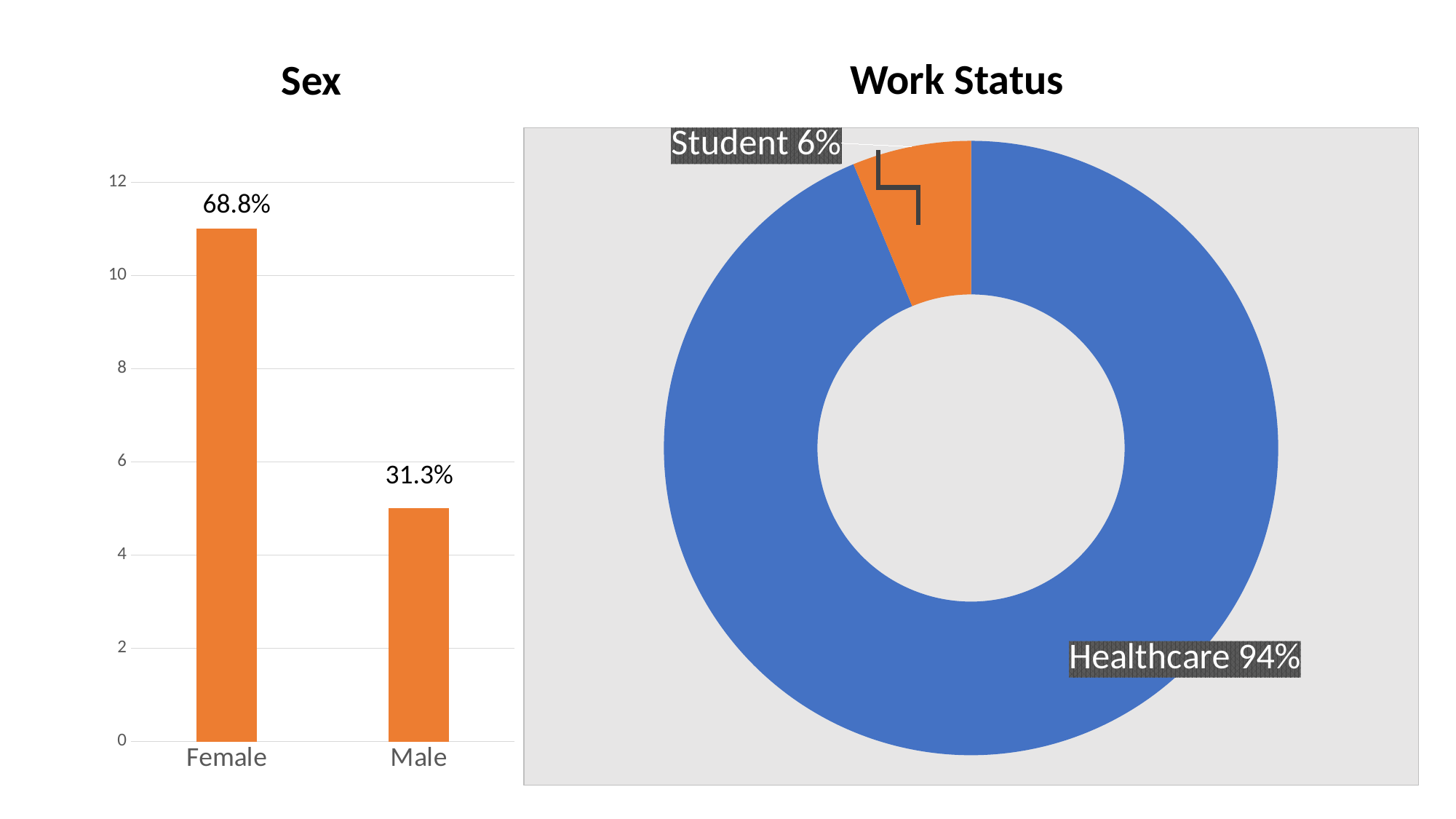
In the Work Status chart, what percentage is labelled for Healthcare? 94% In the Work Status chart, what percentage is labelled for Student? 6% In the Sex chart, how many categories are shown on the x axis? 2 In the Sex chart, which category has the shorter bar? Male In the Sex chart, what is the data label shown for Male? 31.3% In the Work Status chart, what colour is the Student segment? Orange In the Sex chart, is the Female bar greater or less than 10 on the vertical axis? greater In the Sex chart, which category has the taller bar? Female In the Sex chart, what is the data label shown for Female? 68.8% In the Work Status chart, which category has the larger share? Healthcare In the Sex chart, is the Male bar greater or less than 6 on the vertical axis? less What kind of chart is the Sex chart? Bar chart